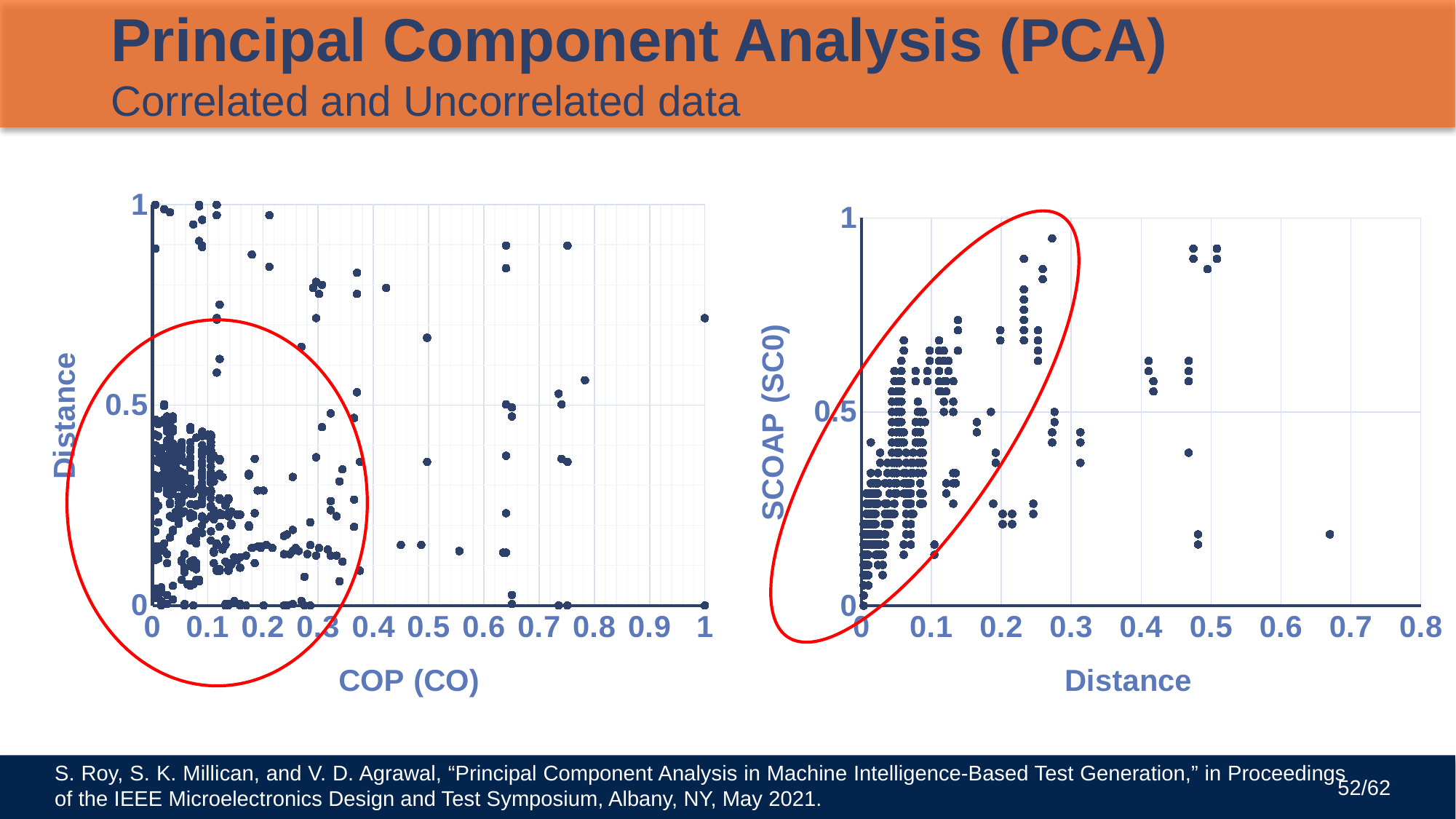
What is the x-axis label of the left chart? COP (CO) What kind of chart is the right chart with x-axis Distance? scatter plot How many charts are shown on the slide? 2 What is the y-axis label of the right chart? SCOAP (SC0) What kind of chart is the left chart with x-axis COP (CO)? scatter plot On the right chart, what is the maximum value shown on the x-axis (Distance)? 0.8 On the left chart, what is the maximum value shown on the x-axis (COP (CO))? 1 On the right chart, do the points inside the red ellipse generally rise or fall as Distance increases? rise On the right chart, is the Distance value of the rightmost point greater or less than 0.6? greater On the right chart, is the SCOAP (SC0) value of the highest point greater or less than 0.9? greater On the left chart, what is the middle tick value labeled on the y-axis (Distance)? 0.5